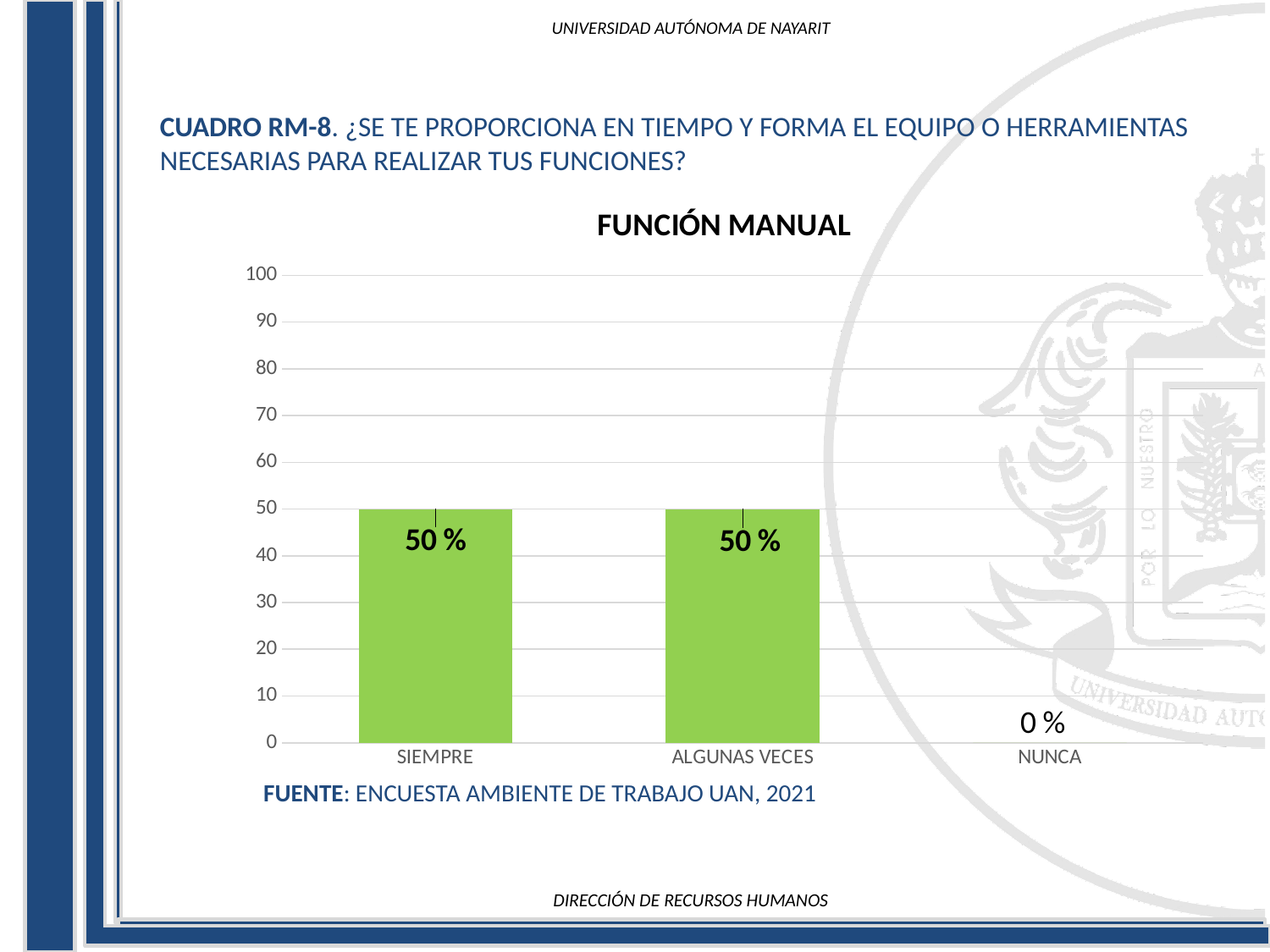
What is the value for ALGUNAS VECES? 50 % What kind of chart is shown on the slide? bar chart Is the value for SIEMPRE greater or less than 40? greater What colour are the bars in the chart? green What is the difference between the values for SIEMPRE and NUNCA? 50 % Which is larger, the value for ALGUNAS VECES or the value for NUNCA? ALGUNAS VECES Which category has the lowest value? NUNCA What is the value for SIEMPRE? 50 % What is the title of the chart? FUNCIÓN MANUAL How many categories are shown on the x axis? 3 What is the value for NUNCA? 0 % What is the highest value shown on the y axis? 100